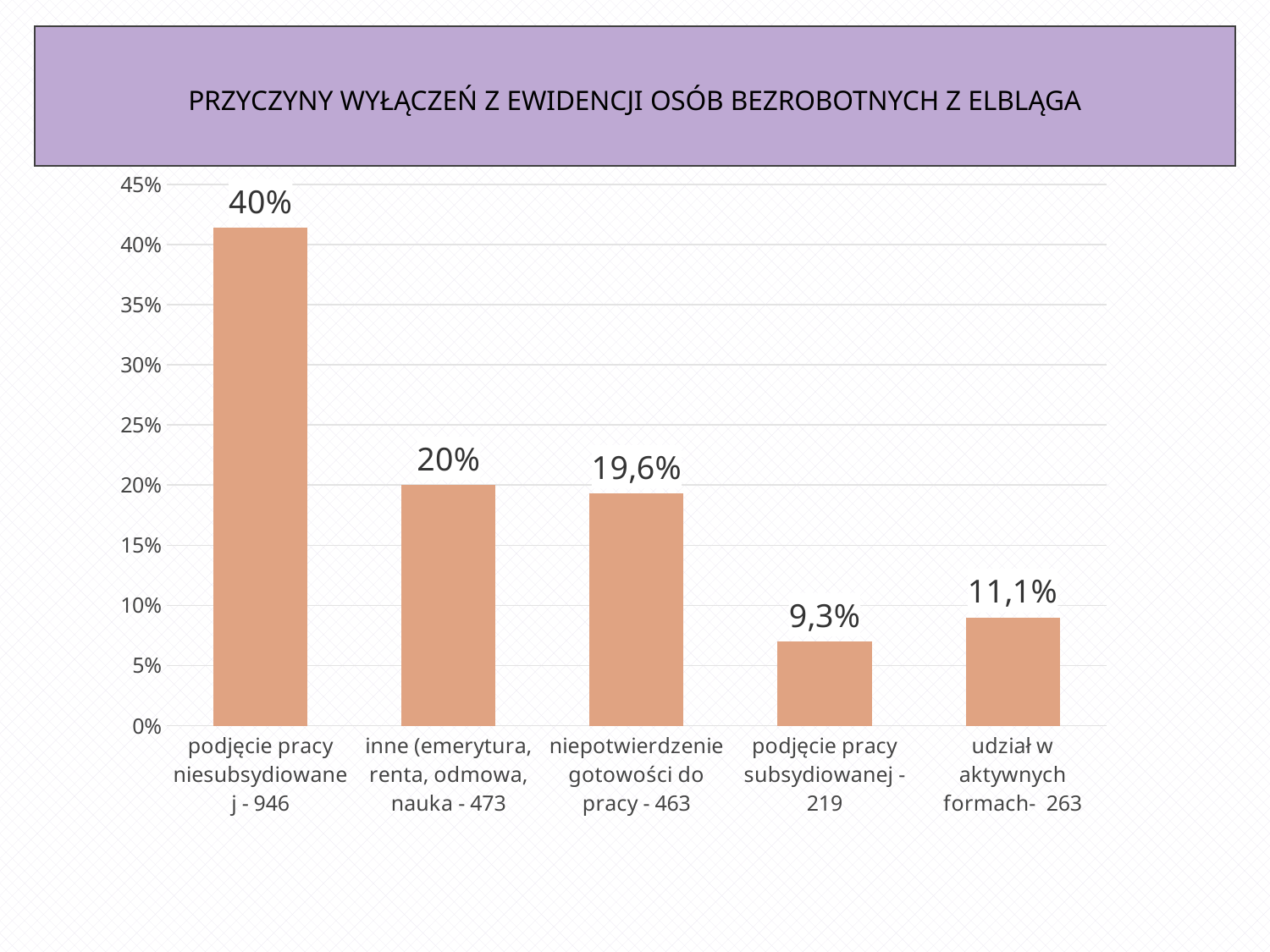
Which is larger: the value for 'inne (emerytura, renta, odmowa, nauka - 473' or for 'niepotwierdzenie gotowości do pracy - 463'? inne (emerytura, renta, odmowa, nauka - 473 What is the title of the slide? PRZYCZYNY WYŁĄCZEŃ Z EWIDENCJI OSÓB BEZROBOTNYCH Z ELBLĄGA What is the value shown for 'podjęcie pracy niesubsydiowanej - 946'? 40% What is the value shown for 'podjęcie pracy subsydiowanej - 219'? 9,3% What is the value shown for 'niepotwierdzenie gotowości do pracy - 463'? 19,6% Which category has the lowest value? podjęcie pracy subsydiowanej - 219 What is the difference between the values for 'udział w aktywnych formach- 263' and 'podjęcie pracy subsydiowanej - 219'? 1,8 percentage points What kind of chart is shown on the slide? bar chart What is the difference between the values for 'podjęcie pracy niesubsydiowanej - 946' and 'inne (emerytura, renta, odmowa, nauka - 473'? 20 percentage points Which category has the highest value? podjęcie pracy niesubsydiowanej - 946 How many categories are shown on the chart? 5 What is the value shown for 'udział w aktywnych formach- 263'? 11,1%